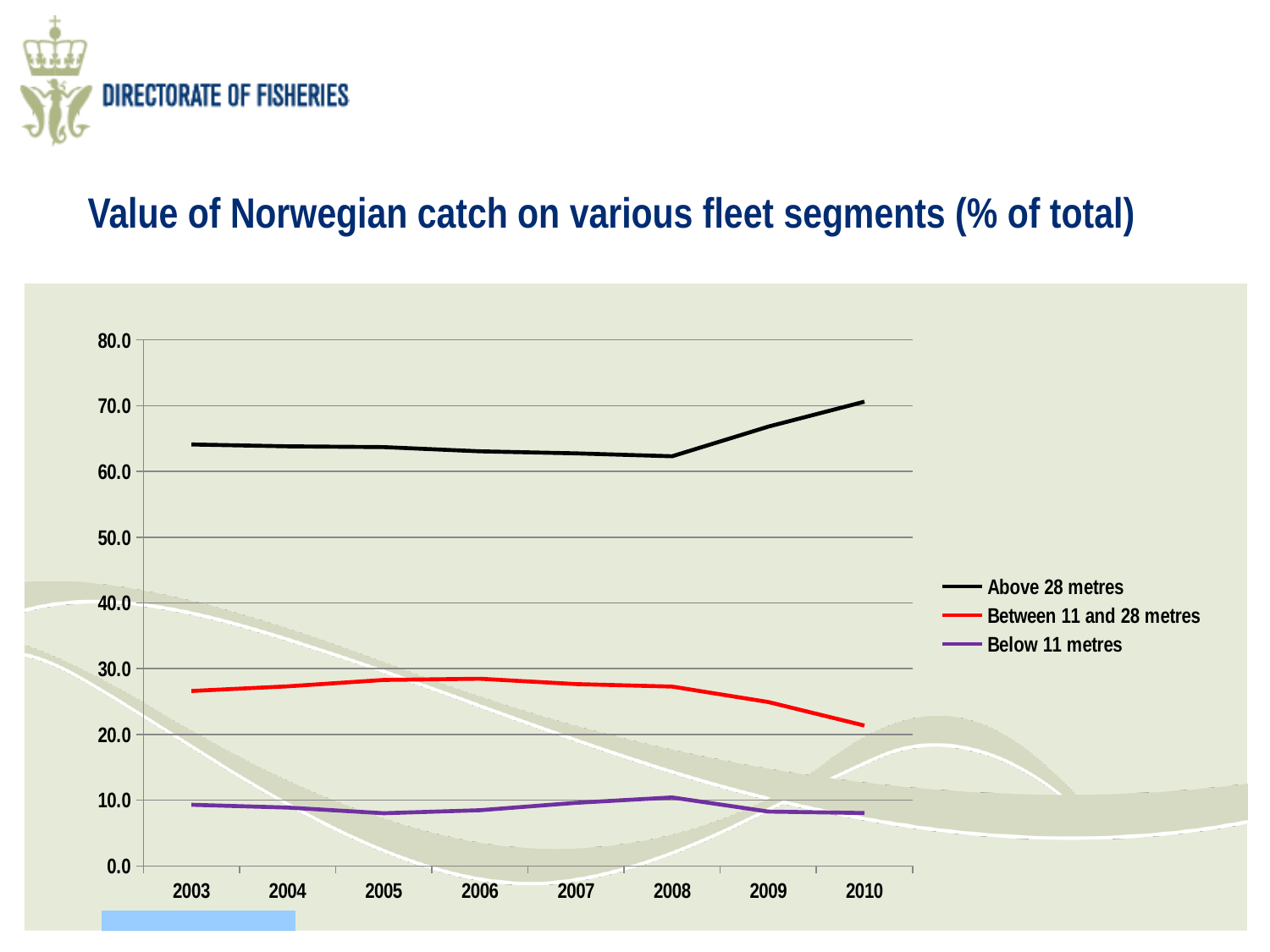
In which year is the value for Between 11 and 28 metres lowest? 2010 Is the value for Above 28 metres in 2010 greater or less than 60.0? greater Which colour is used for the Between 11 and 28 metres line? Red Is the value for Between 11 and 28 metres in 2010 greater or less than 30.0? less Which fleet segment has the highest share of catch value in 2010? Above 28 metres How many years are shown on the x axis? 8 How many series does the legend list? 3 Does the value for Above 28 metres rise or fall from 2008 to 2010? Rises Which fleet segment has the lowest share of catch value in 2003? Below 11 metres What kind of chart is shown on the slide? Line chart Is the value for Below 11 metres in 2005 greater or less than 10.0? less In which year is the value for Above 28 metres highest? 2010